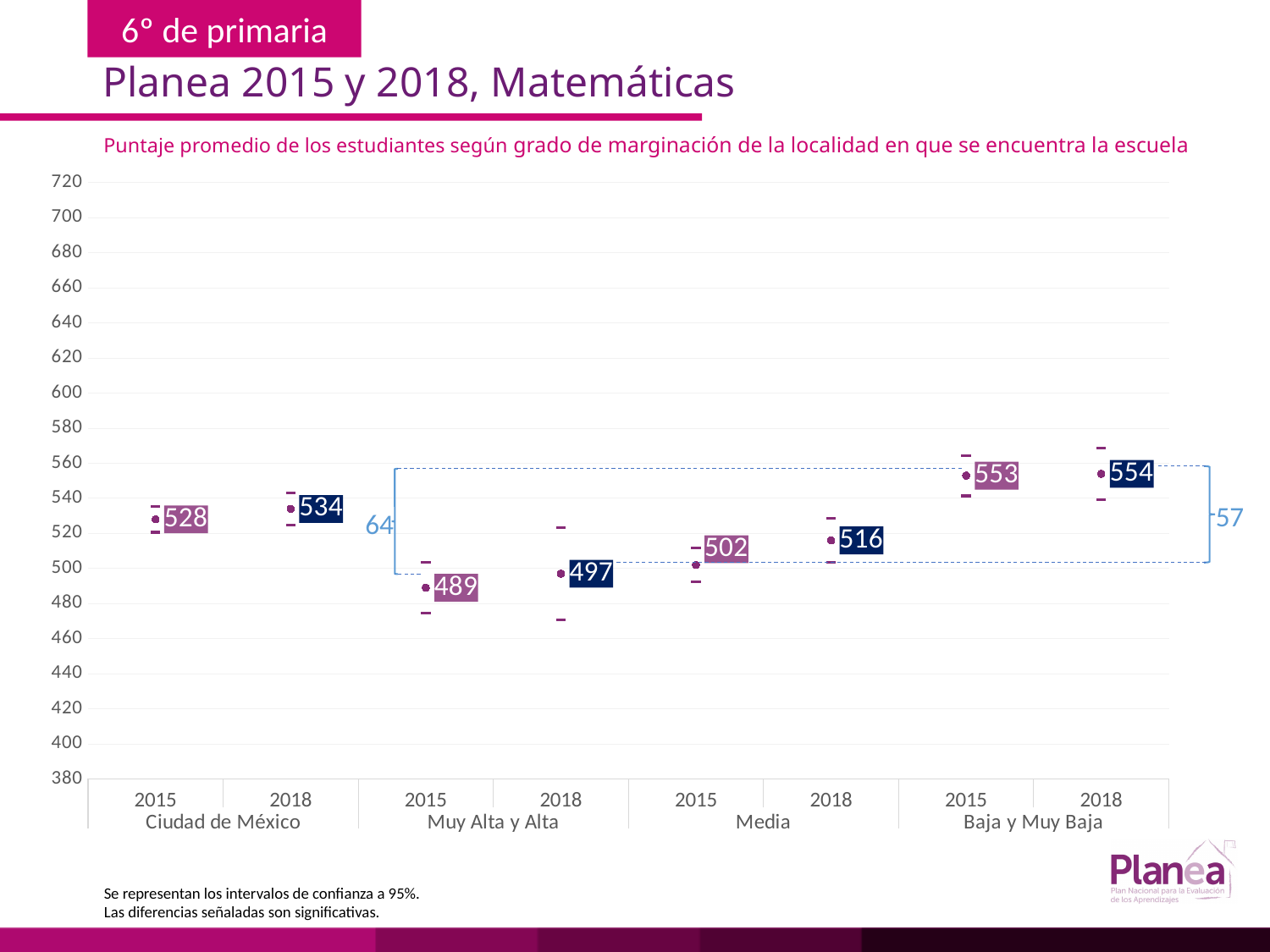
Is the 2015 score for Muy Alta y Alta greater or less than 500? less Which is larger, the 2018 score for Ciudad de México or the 2018 score for Media? Ciudad de México (534) What is the difference between the 2015 scores of Baja y Muy Baja and Muy Alta y Alta? 64 Which group and year has the lowest average score? Muy Alta y Alta, 2015 (489) What is the difference between the 2018 and 2015 scores for Media? 14 What is the average score for Baja y Muy Baja in 2015? 553 What is the average score for Muy Alta y Alta in 2018? 497 How many marginalization groups are shown on the x axis? 4 Which group and year has the highest average score? Baja y Muy Baja, 2018 (554) What is the subtitle of the chart? Puntaje promedio de los estudiantes según grado de marginación de la localidad en que se encuentra la escuela What is the average score for Ciudad de México in 2015? 528 What is the average score for Media in 2018? 516